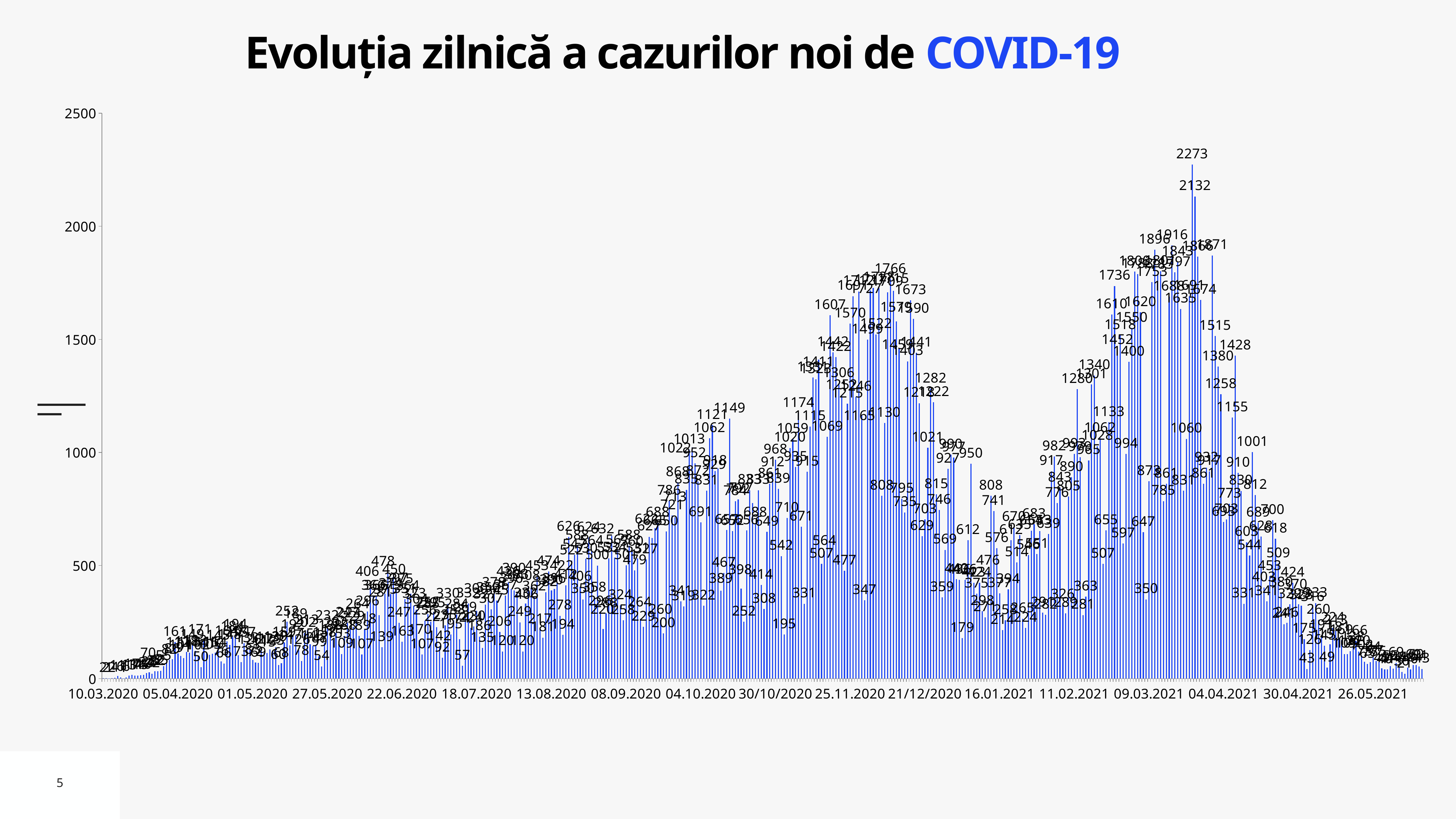
What is the difference between the two highest labelled values, 2273 and 2132? 141 What is the title of the chart? Evoluția zilnică a cazurilor noi de COVID-19 Is the bar at the far right end of the chart (late May 2021) greater or less than 500? less Do the values rise or fall from the 2273 peak toward 26.05.2021? fall What is the second-highest value labelled on the chart, just below the 2273 peak? 2132 What kind of chart is shown on the slide? bar chart Is the highest bar on the chart greater or less than 2000? greater What is the highest daily value labelled on the chart? 2273 Do the values rise or fall from 10.03.2020 to 05.04.2020? rise Which is larger, the bar labelled 2273 or the bar labelled 2132? 2273 What colour are the bars in the chart? blue